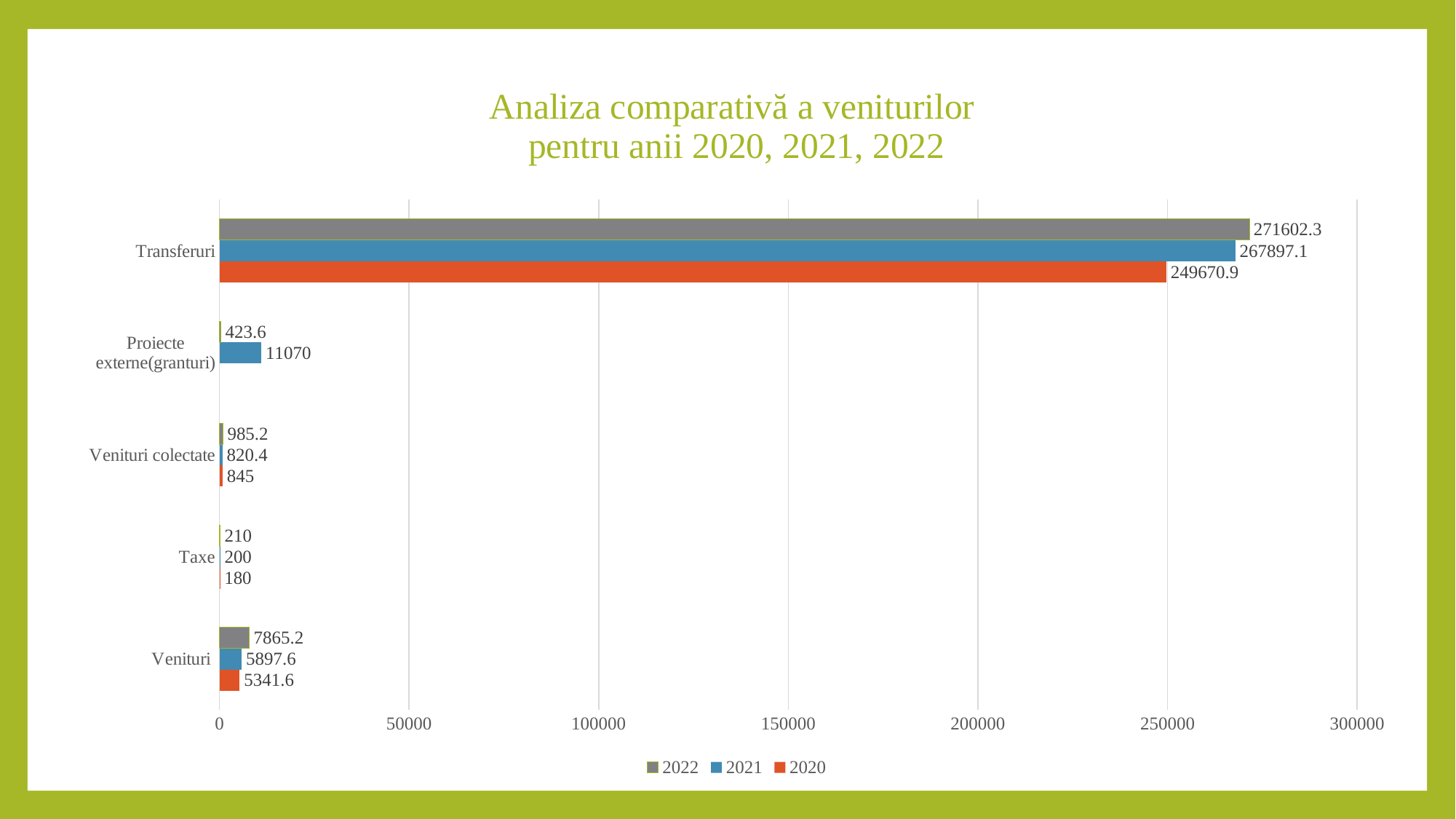
What is the difference between the 2022 and 2021 values for Transferuri? 3705.2 What is the difference between the 2022 and 2020 values for Taxe? 30 Which category has the highest value in the 2021 series? Transferuri How many series does the legend list? 3 What is the value for Proiecte externe(granturi) in 2021? 11070 How many categories are shown on the chart? 5 What is the value for Venituri colectate in 2020? 845 What kind of chart is shown on the slide? Bar chart What is the value for Transferuri in 2022? 271602.3 Which is larger for Venituri colectate: the 2021 value or the 2020 value? 2020 What is the value for Venituri in 2022? 7865.2 Which category has the lowest value in the 2020 series? Taxe